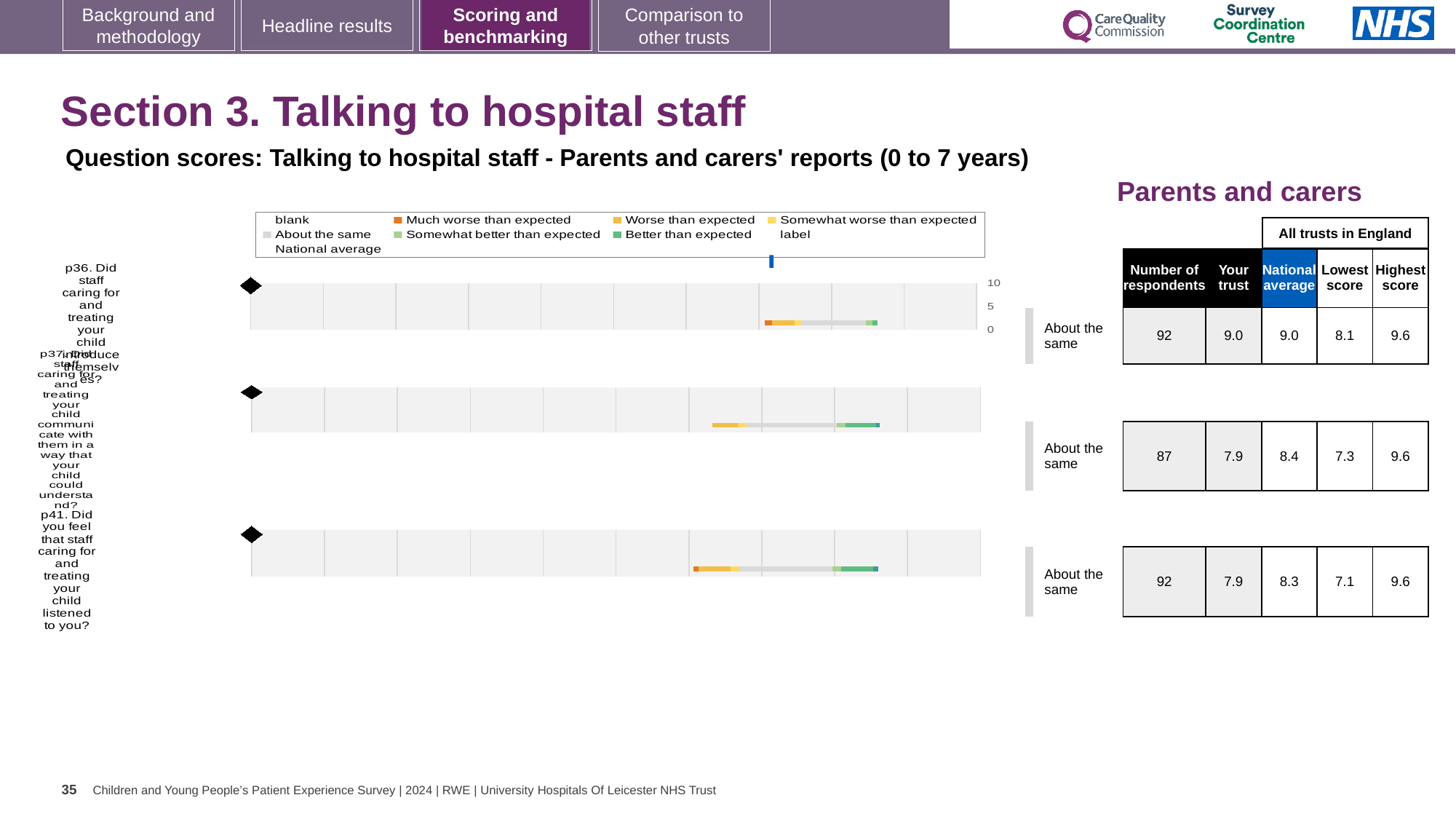
How many entries does the chart legend list? 9 Which question has the highest 'Your trust' score? p36 For p41 (Did you feel staff listened to you), which is larger: the 'Your trust' score or the National average? National average What colour does the legend use for 'Much worse than expected'? orange What colour does the legend use for 'Better than expected'? green In the table beside the chart, how many respondents answered p37? 87 What benchmark category is shown for p41 next to the chart? About the same In the table beside the chart, what is the 'Your trust' score for p36 (Did staff caring for and treating your child introduce themselves)? 9.0 For p36, what is the difference between the Highest score and the Lowest score across all trusts in England? 1.5 How many survey questions (rows) are plotted in the chart? 3 In the table beside the chart, what is the National average for p37 (Did staff communicate with your child in a way they could understand)? 8.4 What kind of chart is shown on the slide? bar chart